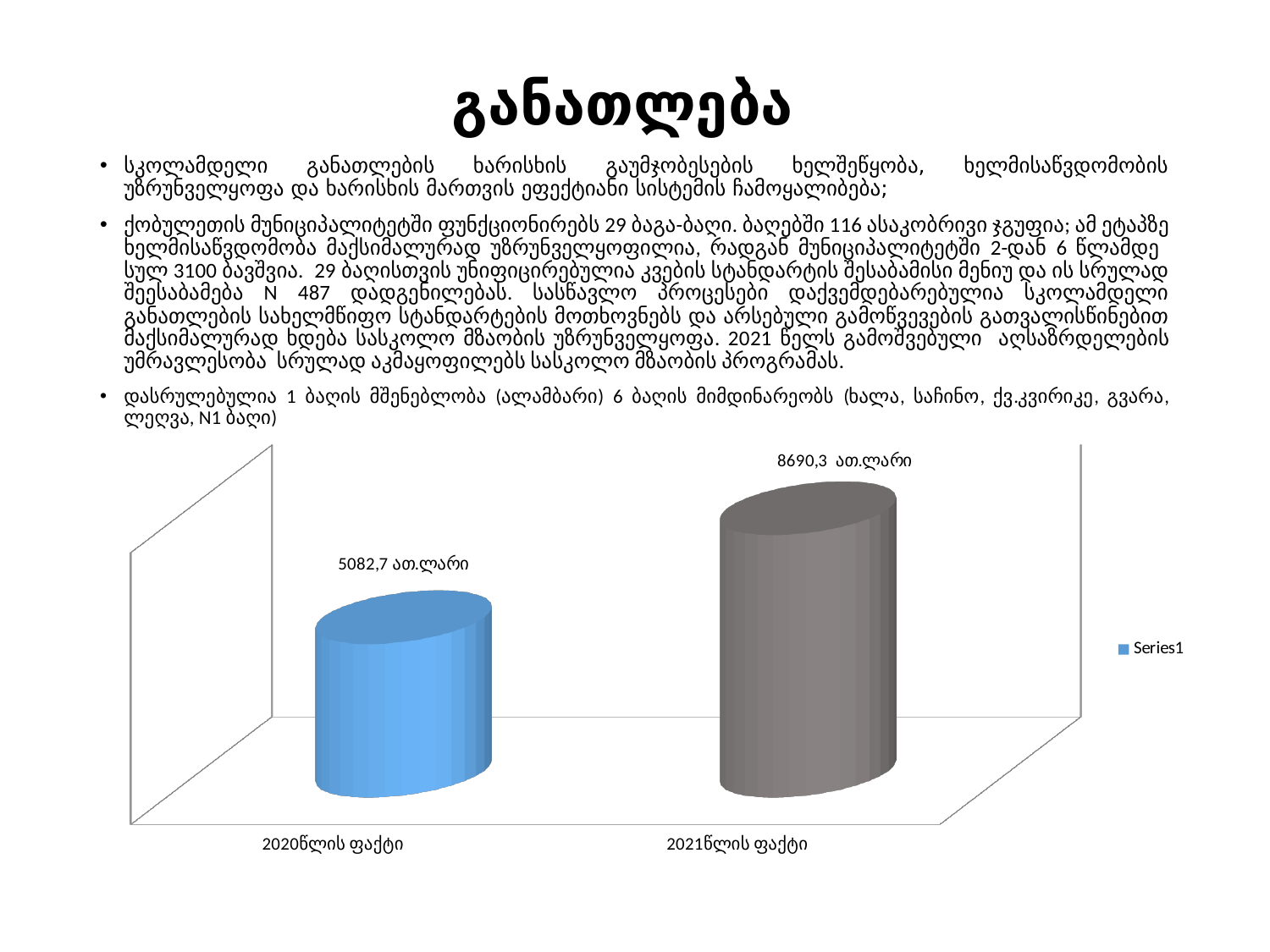
Which category has the highest value? 2021წლის ფაქტი What is the name of the series listed in the legend? Series1 What is the difference between the values for 2021წლის ფაქტი and 2020წლის ფაქტი? 3607,6 ათ.ლარი Do the values rise or fall from 2020წლის ფაქტი to 2021წლის ფაქტი? rise How many categories are shown on the chart? 2 What kind of chart is shown on the slide? bar chart Which category has the lowest value? 2020წლის ფაქტი What is the value for 2020წლის ფაქტი? 5082,7 ათ.ლარი What colour is the bar for 2020წლის ფაქტი? blue How many series does the legend list? 1 Which is larger, the value for 2020წლის ფაქტი or the value for 2021წლის ფაქტი? 2021წლის ფაქტი What is the value for 2021წლის ფაქტი? 8690,3 ათ.ლარი